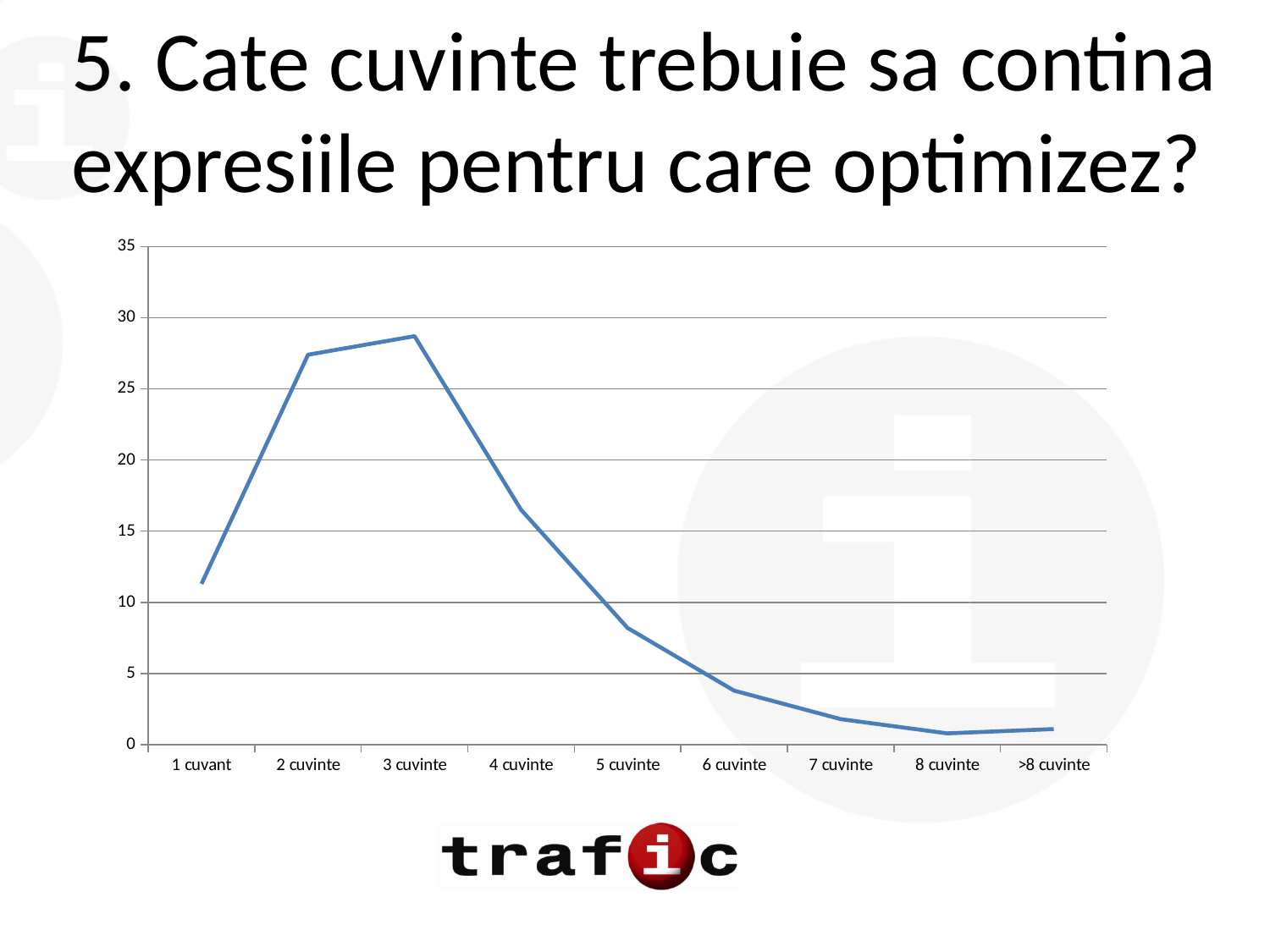
How many categories are plotted along the x axis? 9 Which is larger, the value for 2 cuvinte or the value for 4 cuvinte? 2 cuvinte Is the value for 4 cuvinte greater or less than 15? greater Which category has the highest value? 3 cuvinte Which is larger, the value for 1 cuvant or the value for 5 cuvinte? 1 cuvant Do the values rise or fall from 3 cuvinte to 8 cuvinte? fall What kind of chart is shown on the slide? line chart What is the highest value shown on the vertical axis? 35 Is the value for 6 cuvinte greater or less than 5? less Is the value for 1 cuvant greater or less than 10? greater